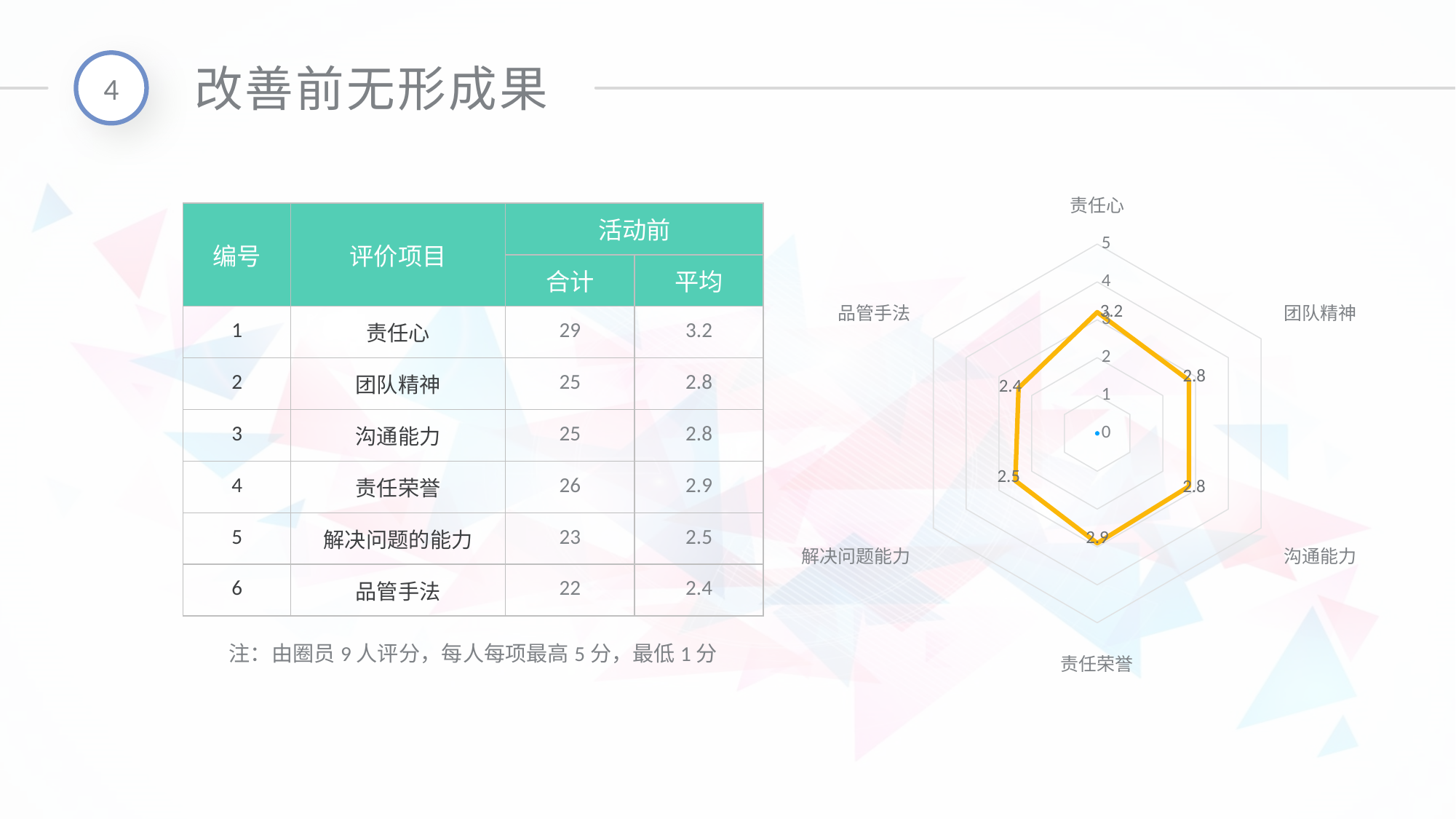
How many categories (axes) does the radar chart have? 6 Which category has the highest value in the radar chart? 责任心 Is the value for 责任心 in the radar chart greater or less than 3? greater What is the value for 责任心 in the radar chart? 3.2 What is the maximum value shown on the radar chart's axis scale? 5 What is the value for 责任荣誉 in the radar chart? 2.9 What is the value for 解决问题能力 in the radar chart? 2.5 Which is larger in the radar chart, the value for 责任荣誉 or the value for 解决问题能力? 责任荣誉 What kind of chart is shown on the right side of the slide? radar chart What is the difference between the values for 责任心 and 品管手法 in the radar chart? 0.8 What is the value for 品管手法 in the radar chart? 2.4 Which category has the lowest value in the radar chart? 品管手法